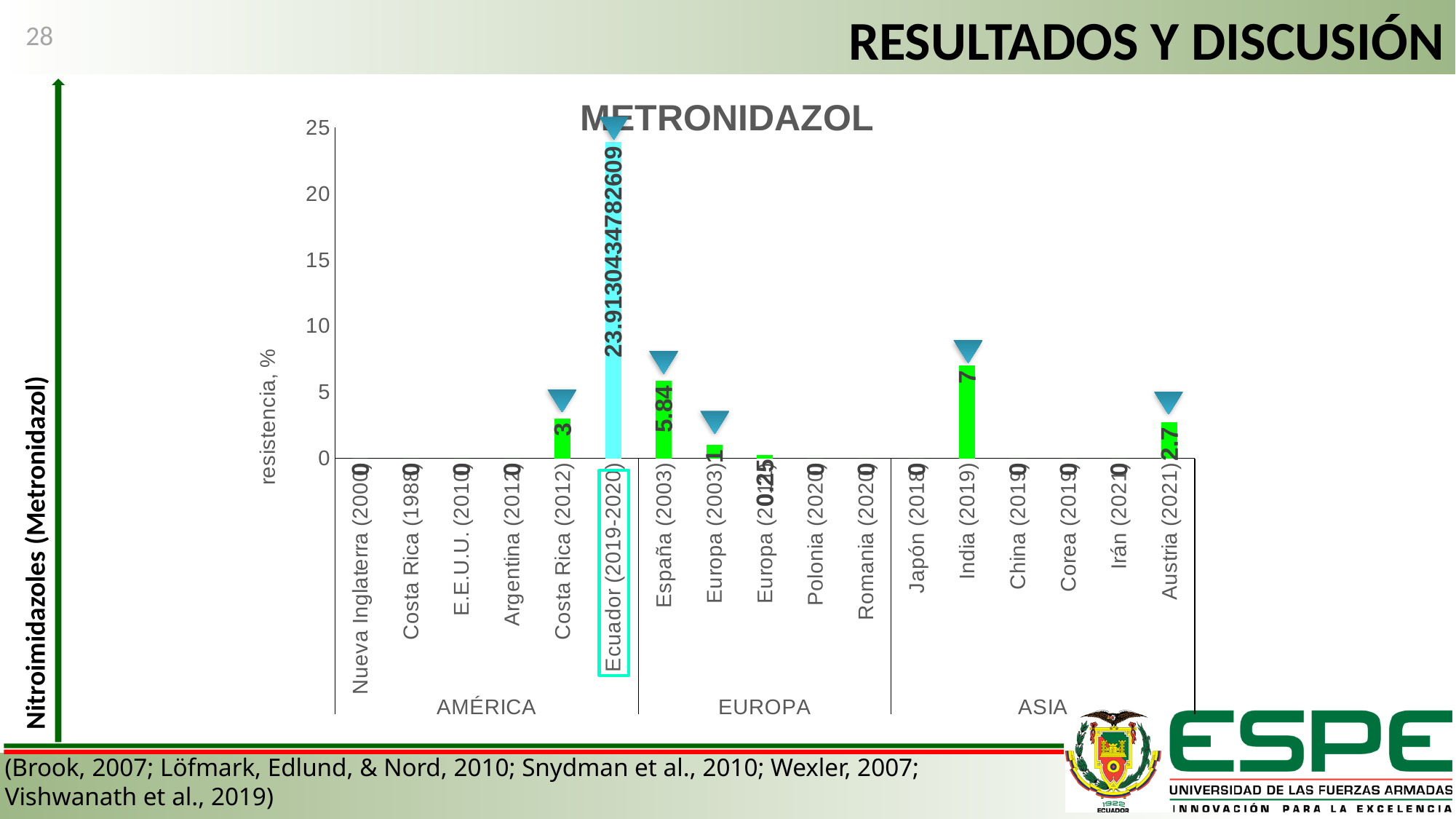
What is the difference between the values for India (2019) and España (2003)? 1.16 Which category has the highest resistance value? Ecuador (2019-2020) What is the title of the chart? METRONIDAZOL What is the resistance value for India (2019)? 7 What is the resistance value for Costa Rica (2012)? 3 Which is larger, the value for India (2019) or the value for España (2003)? India (2019) How many categories are shown on the x axis of the chart? 17 Is the value for Ecuador (2019-2020) greater or less than 20? greater What kind of chart is shown on the slide? bar chart What is the resistance value for Austria (2021)? 2.7 What is the resistance value for España (2003)? 5.84 What is the resistance value for Ecuador (2019-2020)? 23.9130434782609